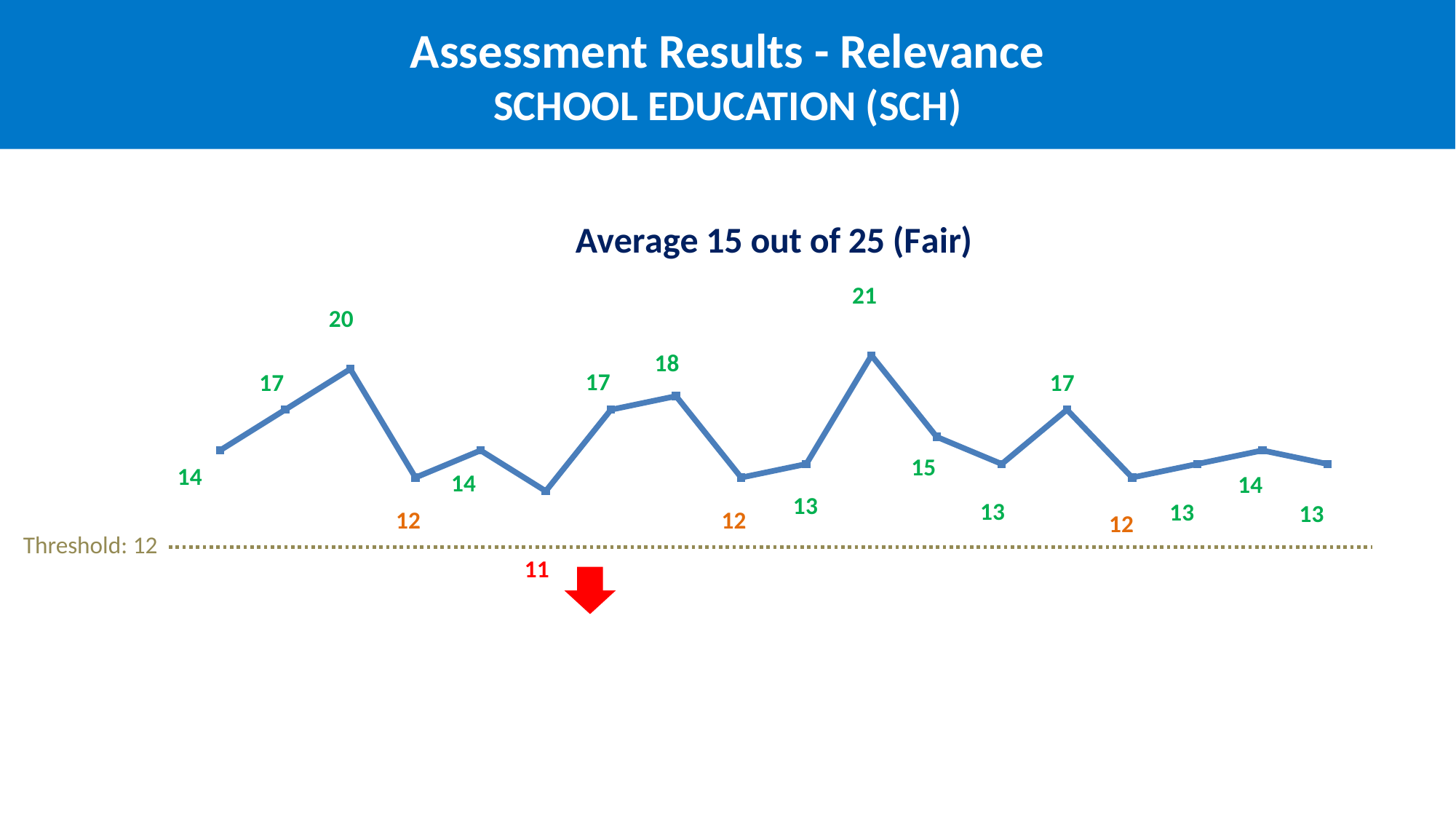
What is the average score stated in the chart title? 15 out of 25 (Fair) What is the value of the first data point on the line chart? 14 What is the difference between the highest and lowest values on the line chart? 10 How many data points on the chart fall below the threshold of 12? 1 How many data points on the chart have a value of exactly 12? 3 What is the value of the last data point on the line chart? 13 What is the highest value plotted on the line chart? 21 What threshold value is marked by the dotted line on the chart? 12 What type of chart is shown on the slide? line chart How many data points are plotted on the line chart? 18 Is the value of the third data point on the line chart greater or less than 15? greater What is the lowest value plotted on the line chart? 11